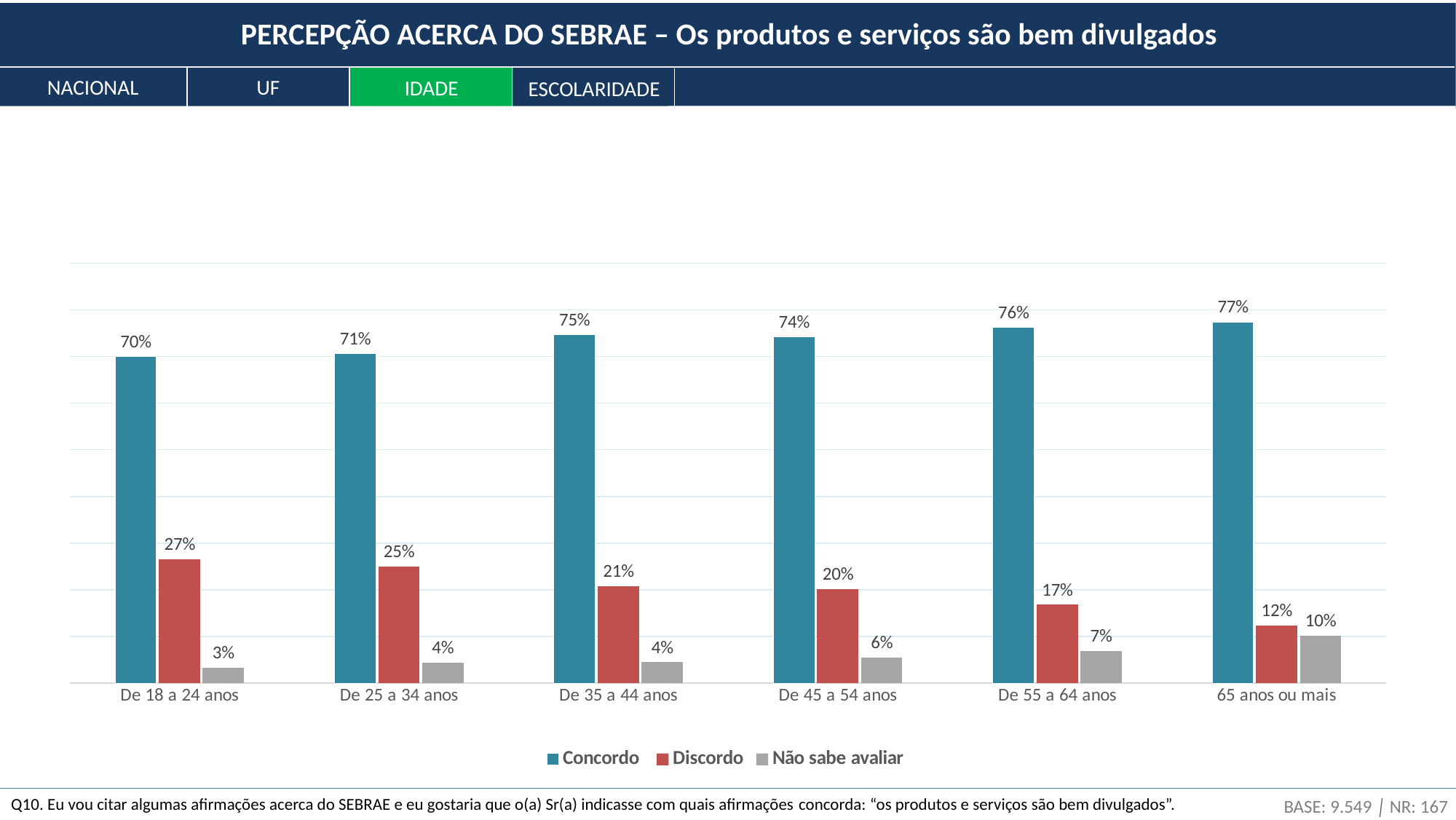
What is the Não sabe avaliar value for 65 anos ou mais? 10% What is the Concordo value for De 18 a 24 anos? 70% Which is larger: the Concordo value for De 45 a 54 anos or for De 35 a 44 anos? De 35 a 44 anos How many age groups are shown on the x axis? 6 Which tab is highlighted in green below the title? IDADE How many series does the legend list? 3 What is the difference between the Discordo values for De 18 a 24 anos and De 55 a 64 anos? 10% What kind of chart is shown on the slide? Bar chart Do the Discordo values rise or fall from De 18 a 24 anos to 65 anos ou mais? Fall What is the Discordo value for De 35 a 44 anos? 21% Which age group has the highest Concordo value? 65 anos ou mais Which age group has the lowest Discordo value? 65 anos ou mais